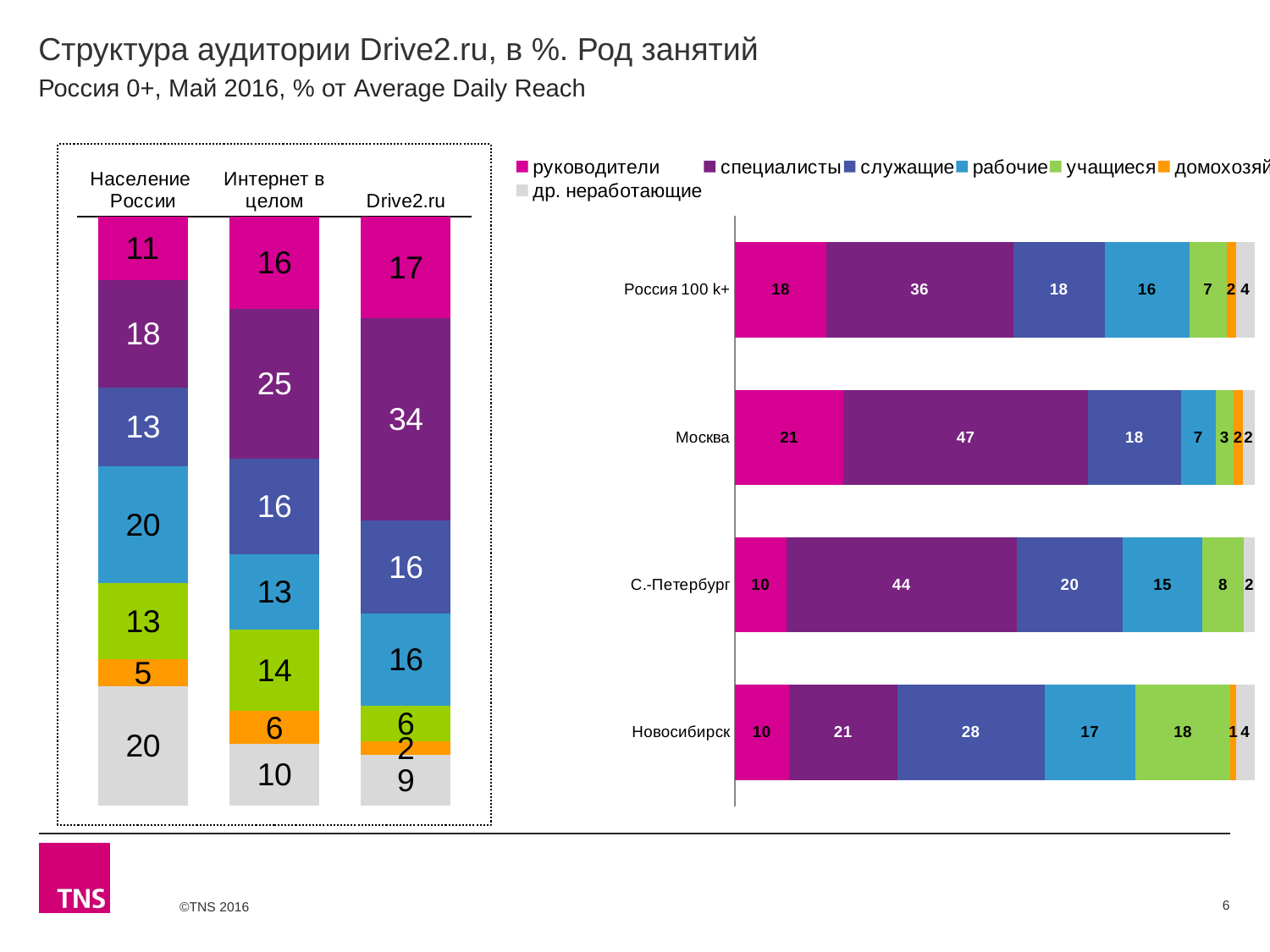
In the left chart, what is the value for специалисты (purple segment) in the Drive2.ru column? 34 In the right chart, what is the value for специалисты (purple segment) for Москва? 47 In the left chart, which column has the largest специалисты (purple) segment? Drive2.ru What kind of chart is the right chart? Stacked bar chart In the right chart, what is the difference between the руководители value for Москва and for С.-Петербург? 11 In the left chart, what is the value for руководители (pink segment) in the Население России column? 11 In the right chart, what is the value for служащие (dark blue segment) for Новосибирск? 28 How many series does the legend of the right chart list? 7 In the left chart, which is larger: the др. неработающие (grey) value for Население России or for Drive2.ru? Население России In the left chart, what is the value for учащиеся (green segment) in the Интернет в целом column? 14 In the left chart, what is the difference between the специалисты value for Drive2.ru and for Интернет в целом? 9 In the right chart, which city has the lowest специалисты (purple) value? Новосибирск